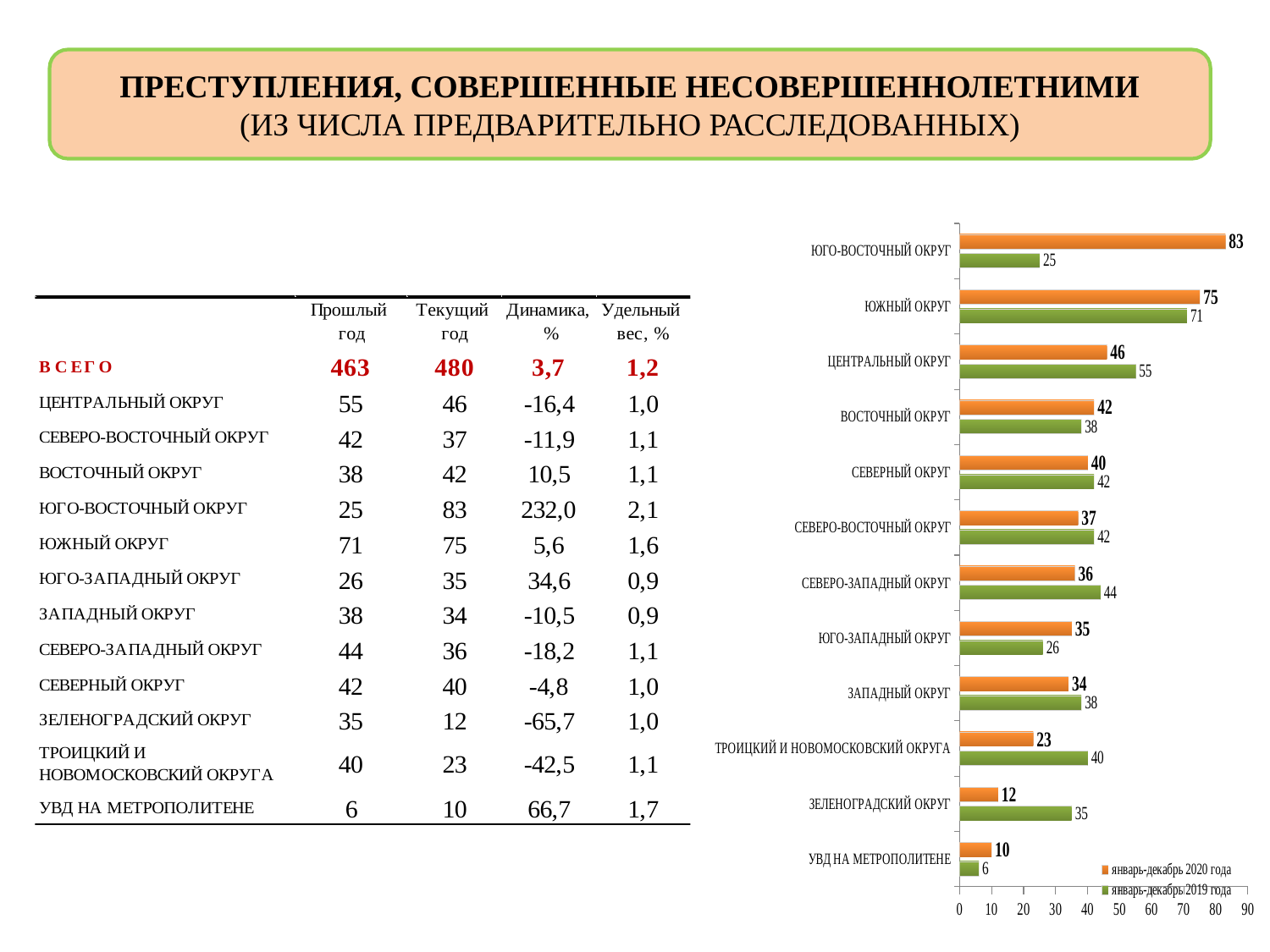
What is the value for ЗЕЛЕНОГРАДСКИЙ ОКРУГ in the январь-декабрь 2019 года series? 35 What is the value for ЮГО-ВОСТОЧНЫЙ ОКРУГ in the январь-декабрь 2020 года series? 83 What is the difference between the 2019 and 2020 values for ЗЕЛЕНОГРАДСКИЙ ОКРУГ? 23 What type of chart is shown on the slide? bar chart What colour are the bars for the январь-декабрь 2019 года series? green What is the difference between the 2020 and 2019 values for ЮГО-ВОСТОЧНЫЙ ОКРУГ? 58 Is the value for ЮЖНЫЙ ОКРУГ in the январь-декабрь 2020 года series greater or less than 70? greater Which district has the highest value in the январь-декабрь 2020 года series? ЮГО-ВОСТОЧНЫЙ ОКРУГ How many districts (categories) are plotted on the chart? 12 How many series does the chart legend list? 2 Which category has the lowest value in the январь-декабрь 2019 года series? УВД НА МЕТРОПОЛИТЕНЕ For ТРОИЦКИЙ И НОВОМОСКОВСКИЙ ОКРУГА, which series has the larger value: январь-декабрь 2020 года or январь-декабрь 2019 года? январь-декабрь 2019 года